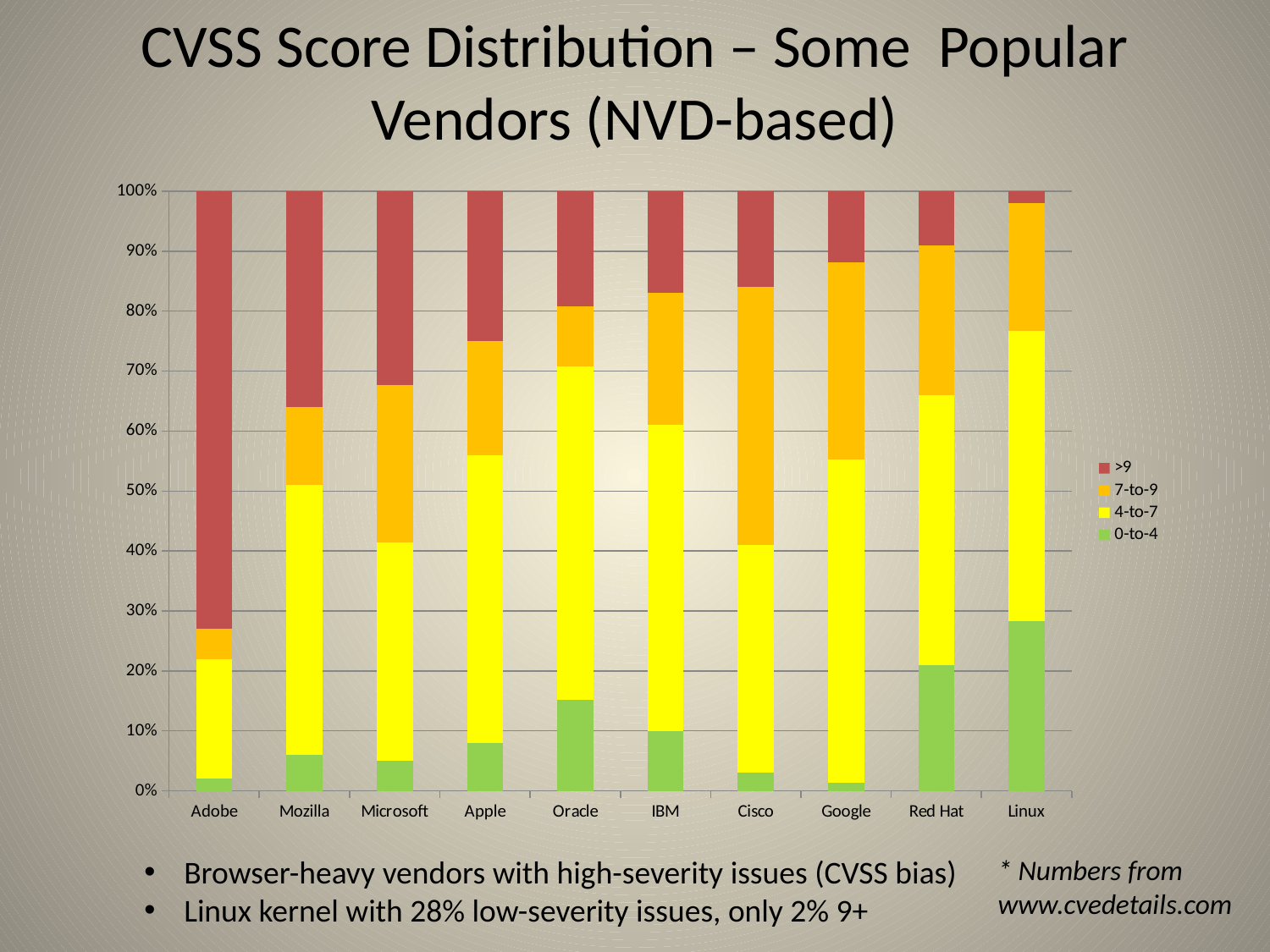
Which vendor has the largest 7-to-9 share in the chart? Cisco Is the 0-to-4 share for Oracle greater or less than 10%? greater Which vendor has the largest 0-to-4 share in the chart? Linux Which vendor has the largest >9 share in the chart? Adobe Which has the larger 0-to-4 share, Oracle or Apple? Oracle What are the four legend entries of the chart? >9, 7-to-9, 4-to-7, 0-to-4 Is the 0-to-4 share for Google greater or less than 10%? less How many series does the chart's legend list? 4 According to the slide, what share of Linux kernel issues are low-severity (0-to-4)? 28% Which vendor has the smallest >9 share in the chart? Linux What kind of chart is shown on the slide? Stacked bar chart How many vendors are shown along the x axis of the chart? 10